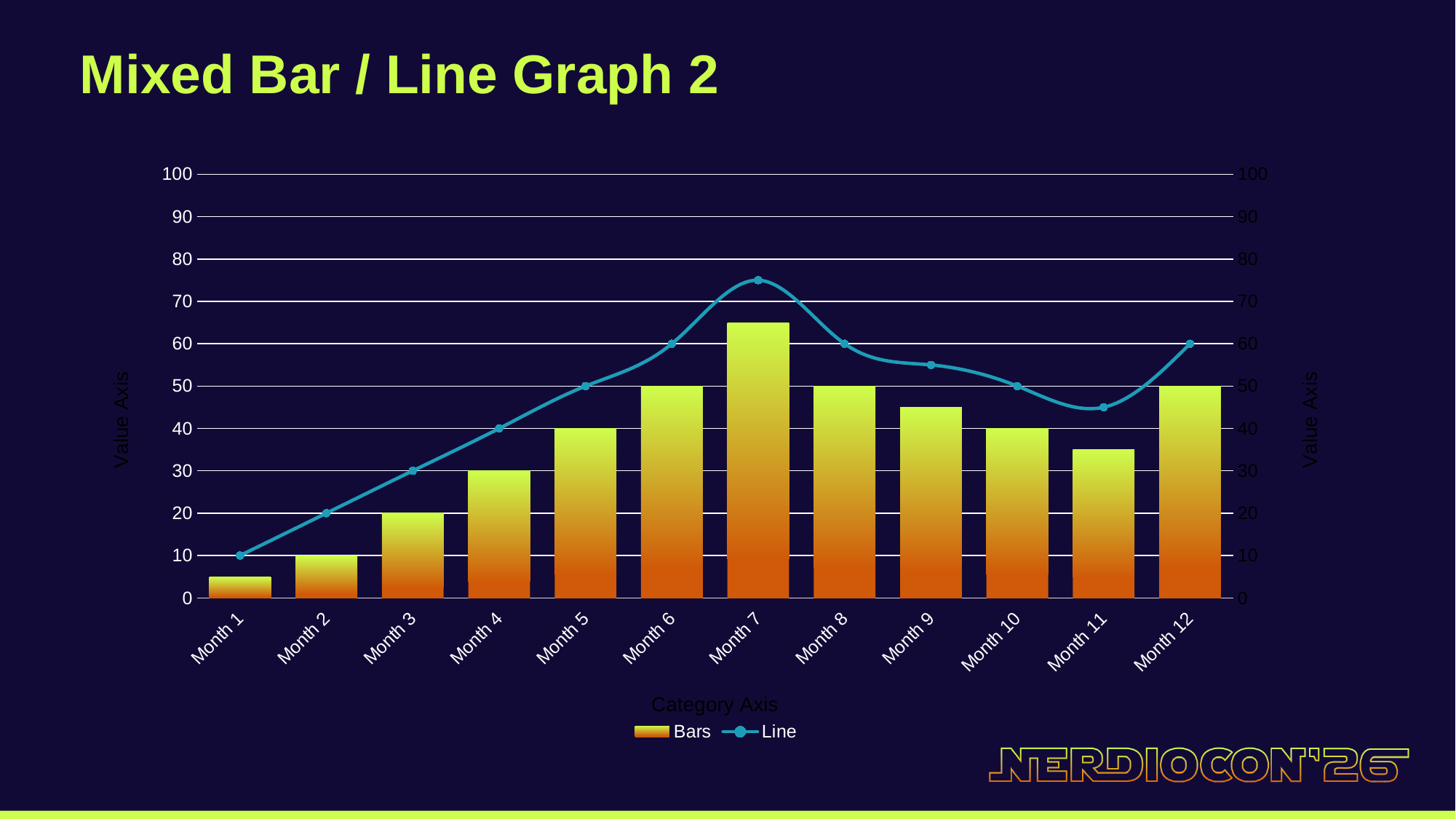
Is the Line value for Month 7 greater or less than 70? greater What is the value of the Bars series for Month 5? 40 Is the bar value for Month 7 greater or less than 60? greater What kind of chart is shown on the slide? A mixed bar and line chart What is the value of the Line series for Month 6? 60 Which month has the highest bar? Month 7 What is the difference between the bar values for Month 5 and Month 3? 20 How many categories are shown on the category axis? 12 Which has the larger bar value, Month 7 or Month 11? Month 7 Which month has the lowest bar? Month 1 How many series does the legend list? 2 Does the Line series rise or fall from Month 1 to Month 7? rises